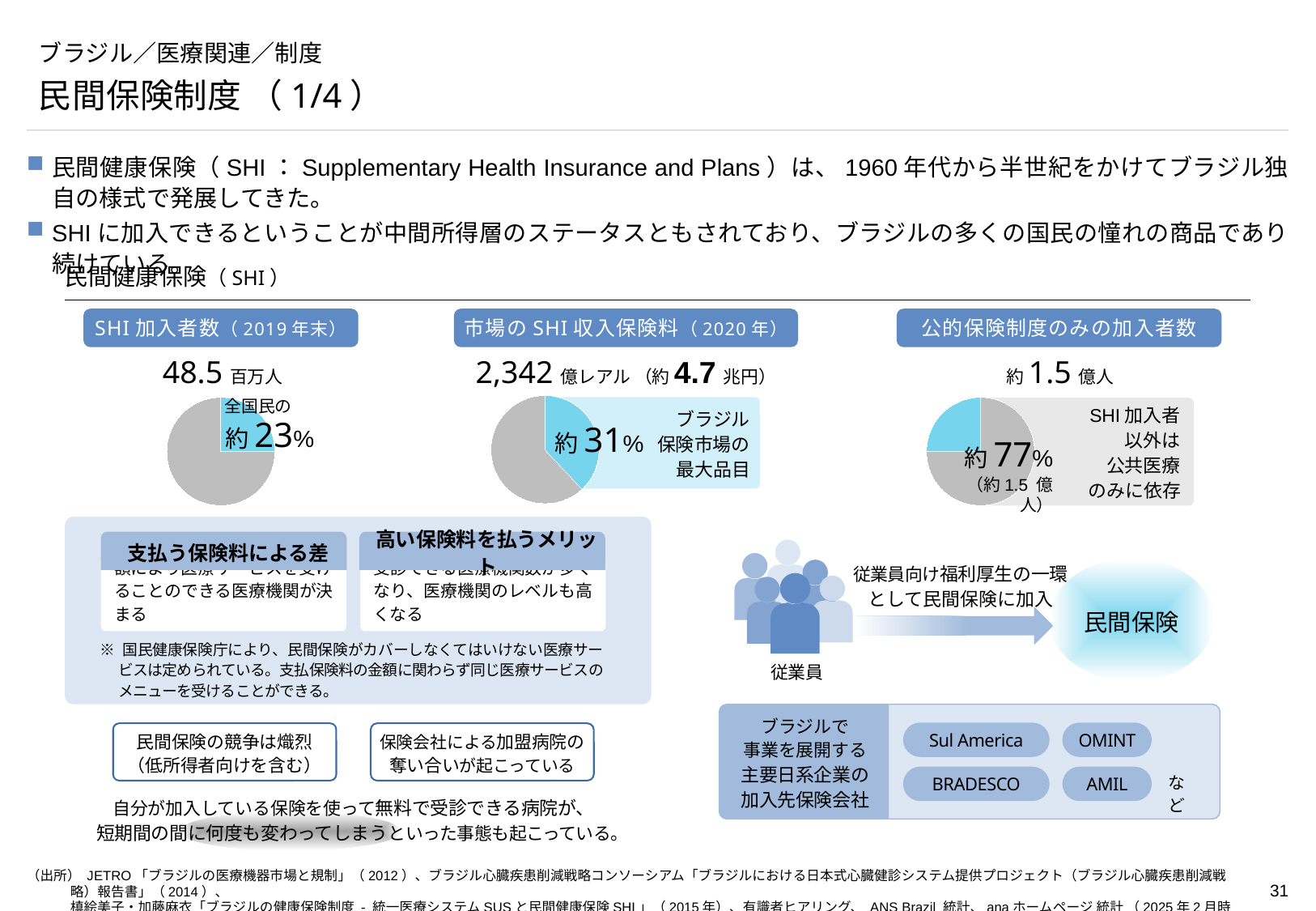
What kind of chart is used under the heading 'SHI加入者数（2019年末）'? pie chart In the pie chart under '公的保険制度のみの加入者数', what share is printed for the large gray slice? 約77% In the pie chart under '公的保険制度のみの加入者数', is the gray slice larger or smaller than the blue slice? larger What value in 億レアル is printed above the pie chart under '市場のSHI収入保険料（2020年）'? 2,342 億レアル What is the difference between the 約31% share in the middle pie chart and the 約23% share in the left pie chart? 8 percentage points How many pie charts are shown on the slide? 3 Which of the three pie charts has the largest highlighted (blue) share: the one under 'SHI加入者数（2019年末）' or the one under '市場のSHI収入保険料（2020年）'? 市場のSHI収入保険料（2020年） In the pie chart under 'SHI加入者数（2019年末）', is the highlighted slice larger or smaller than the gray slice? smaller In the pie chart under 'SHI加入者数（2019年末）', what share of the whole population is labelled for the highlighted slice? 約23% What value is printed above the pie chart under '公的保険制度のみの加入者数'? 約1.5 億人 In the pie chart under '市場のSHI収入保険料（2020年）', what share is printed for the highlighted slice? 約31% What value is printed above the pie chart under 'SHI加入者数（2019年末）'? 48.5 百万人